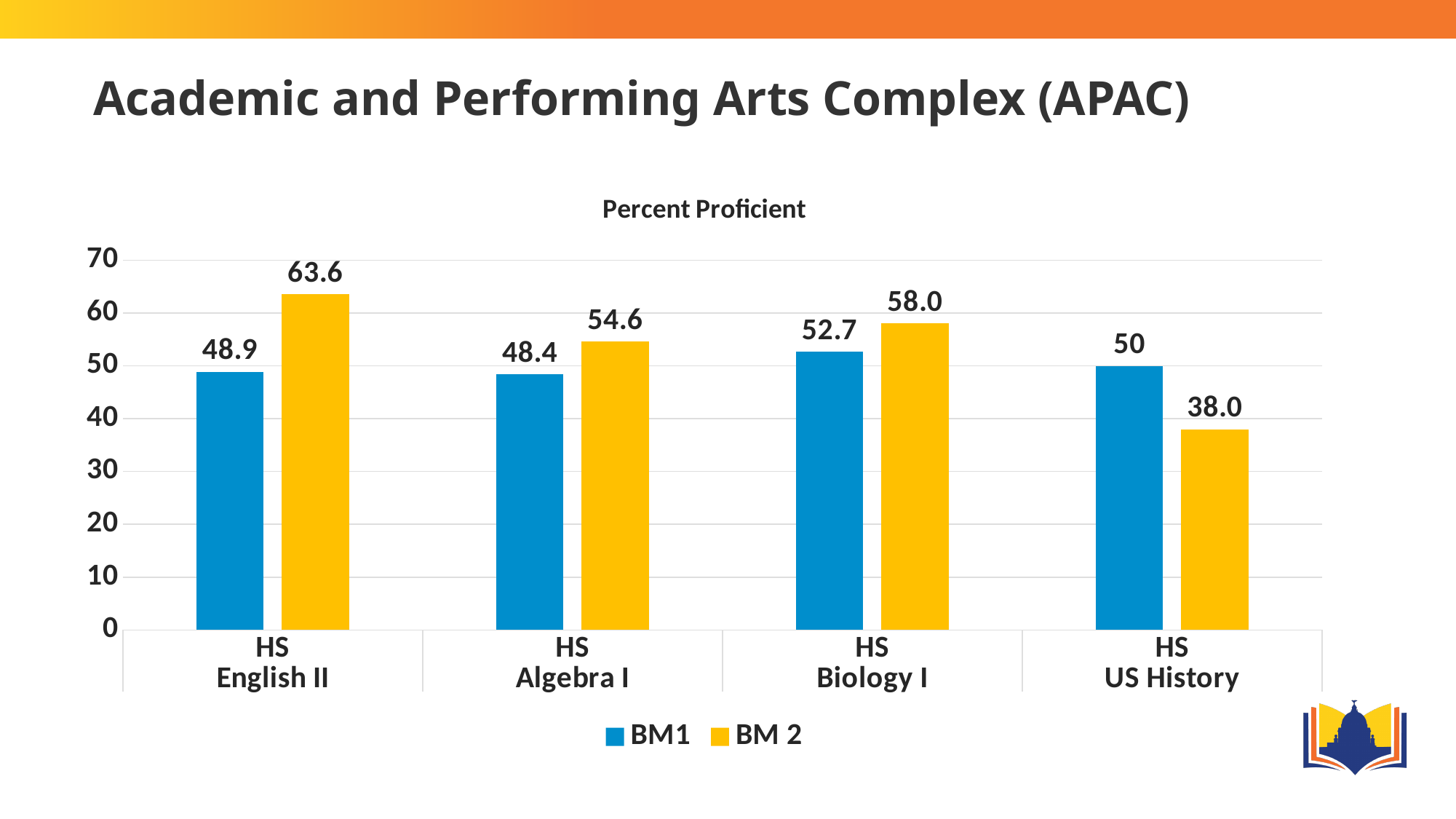
What is the difference between the BM1 and BM 2 values for HS US History? 12.0 Which is larger for HS Biology I, the BM1 value or the BM 2 value? BM 2 What is the BM1 value for HS Algebra I? 48.4 How many categories are shown on the x axis? 4 Which category has the lowest BM 2 value? HS US History Is the BM 2 value for HS US History greater or less than 40? less Which category has the highest BM 2 value? HS English II What is the BM 2 value for HS English II? 63.6 How many series does the legend list? 2 What is the BM1 value for HS US History? 50 What kind of chart is shown on the slide? bar chart What is the difference between the BM 2 and BM1 values for HS English II? 14.7